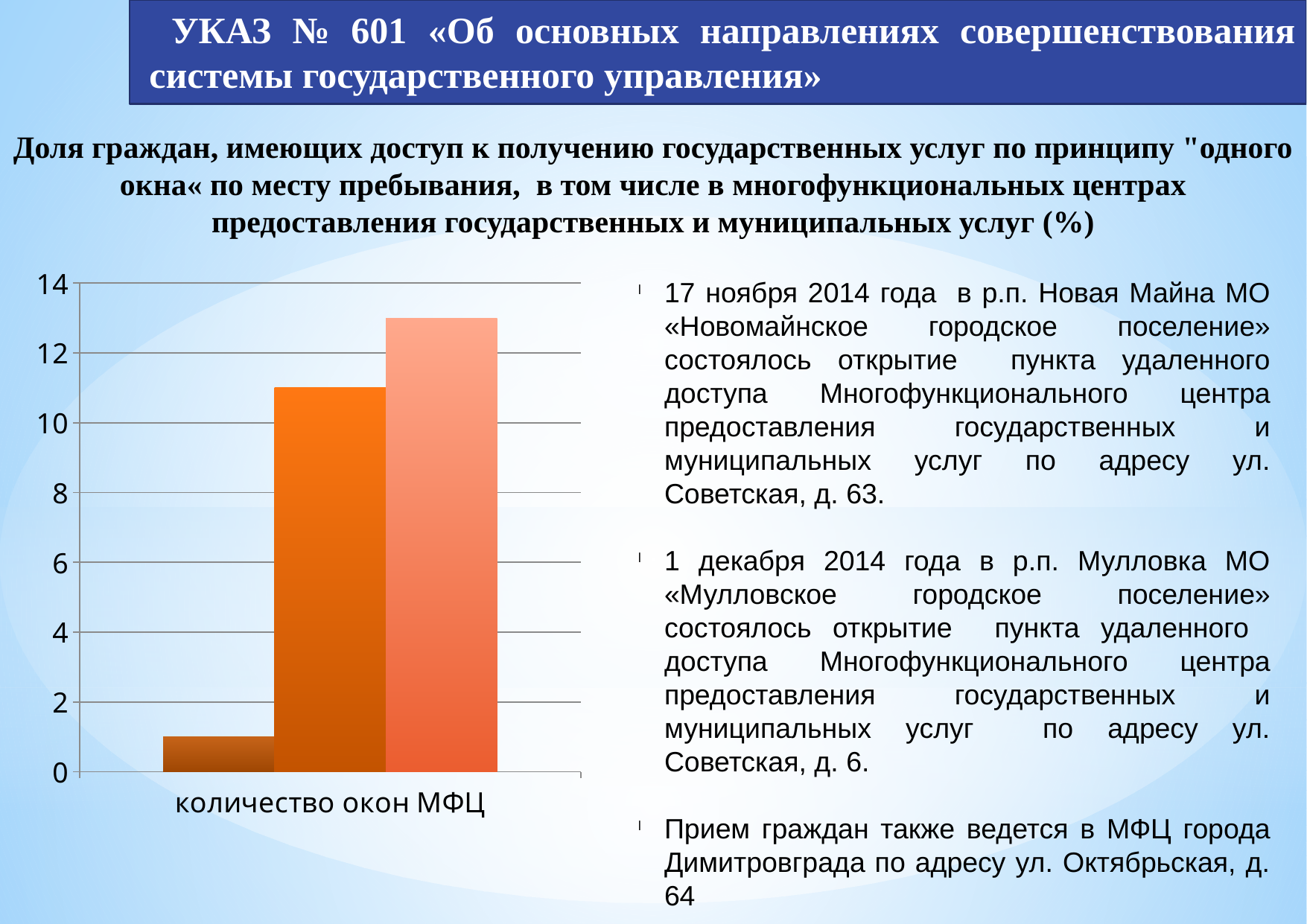
Which bar is the tallest in the chart: the leftmost, the middle, or the rightmost? the rightmost Is the value of the leftmost (dark orange) bar greater or less than 2? less Is the value of the rightmost bar greater or less than 14? less What is the category label shown on the x axis of the chart? количество окон МФЦ What is the highest value shown on the vertical axis of the chart? 14 How many bars are plotted in the chart? 3 Is the value of the rightmost (light orange) bar greater or less than 12? greater What kind of chart is shown on the slide? bar chart Which bar is the shortest in the chart: the leftmost, the middle, or the rightmost? the leftmost Which is larger: the middle bar or the rightmost bar? the rightmost bar Do the bar values rise or fall from left to right in the chart? rise